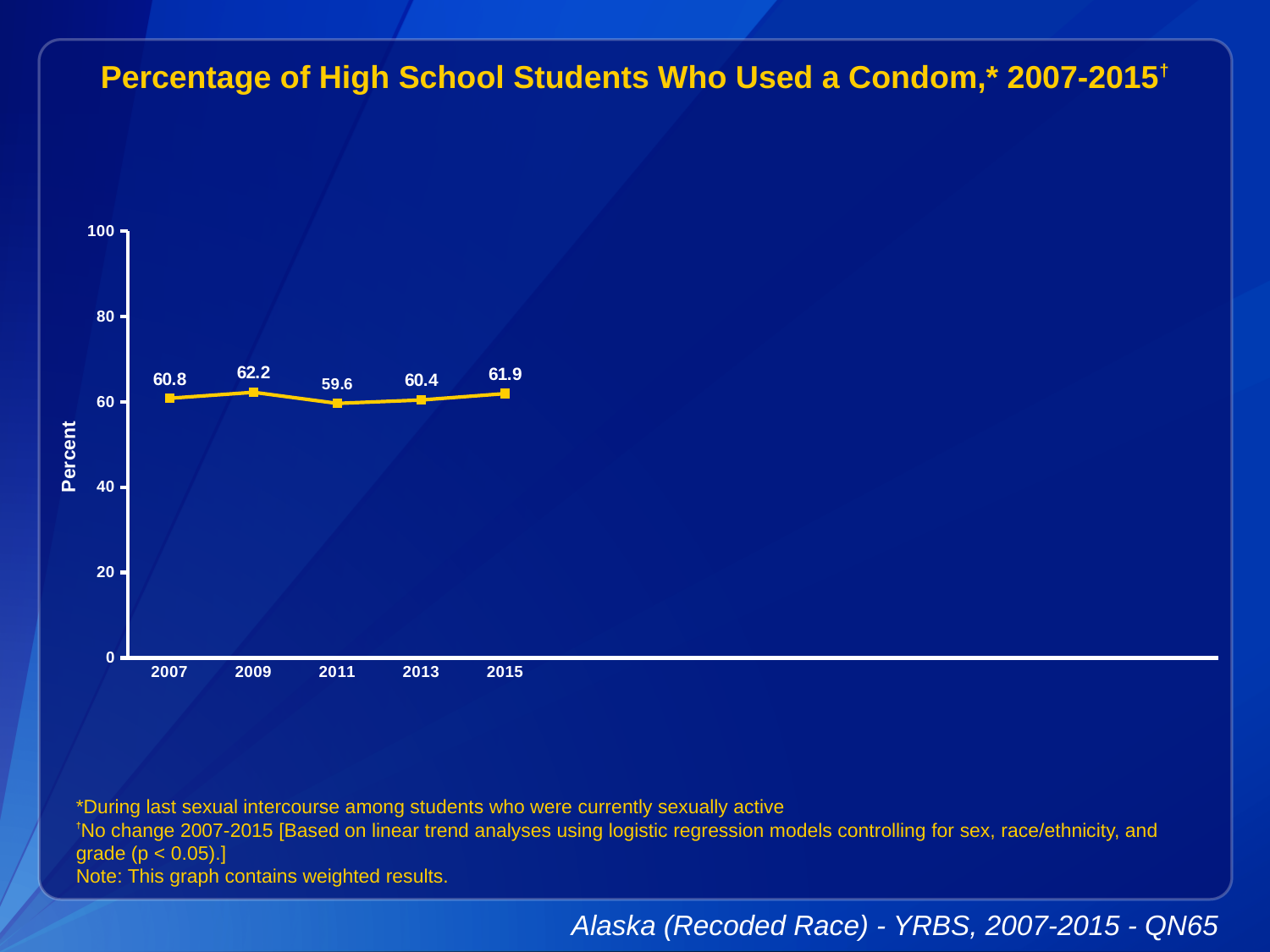
Which year had the highest percentage of students who used a condom? 2009 What was the percentage of high school students who used a condom in 2007? 60.8 What is the difference between the 2015 value and the 2007 value? 1.1 What is the label on the y axis of the chart? Percent How many years are plotted on the chart? 5 What kind of chart is shown on the slide? line chart Which year had the lowest percentage of students who used a condom? 2011 Is the value for 2011 greater or less than 60? less What is the difference between the 2009 value and the 2011 value? 2.6 What was the percentage of high school students who used a condom in 2011? 59.6 Which year had a higher value, 2013 or 2015? 2015 What was the percentage of high school students who used a condom in 2015? 61.9